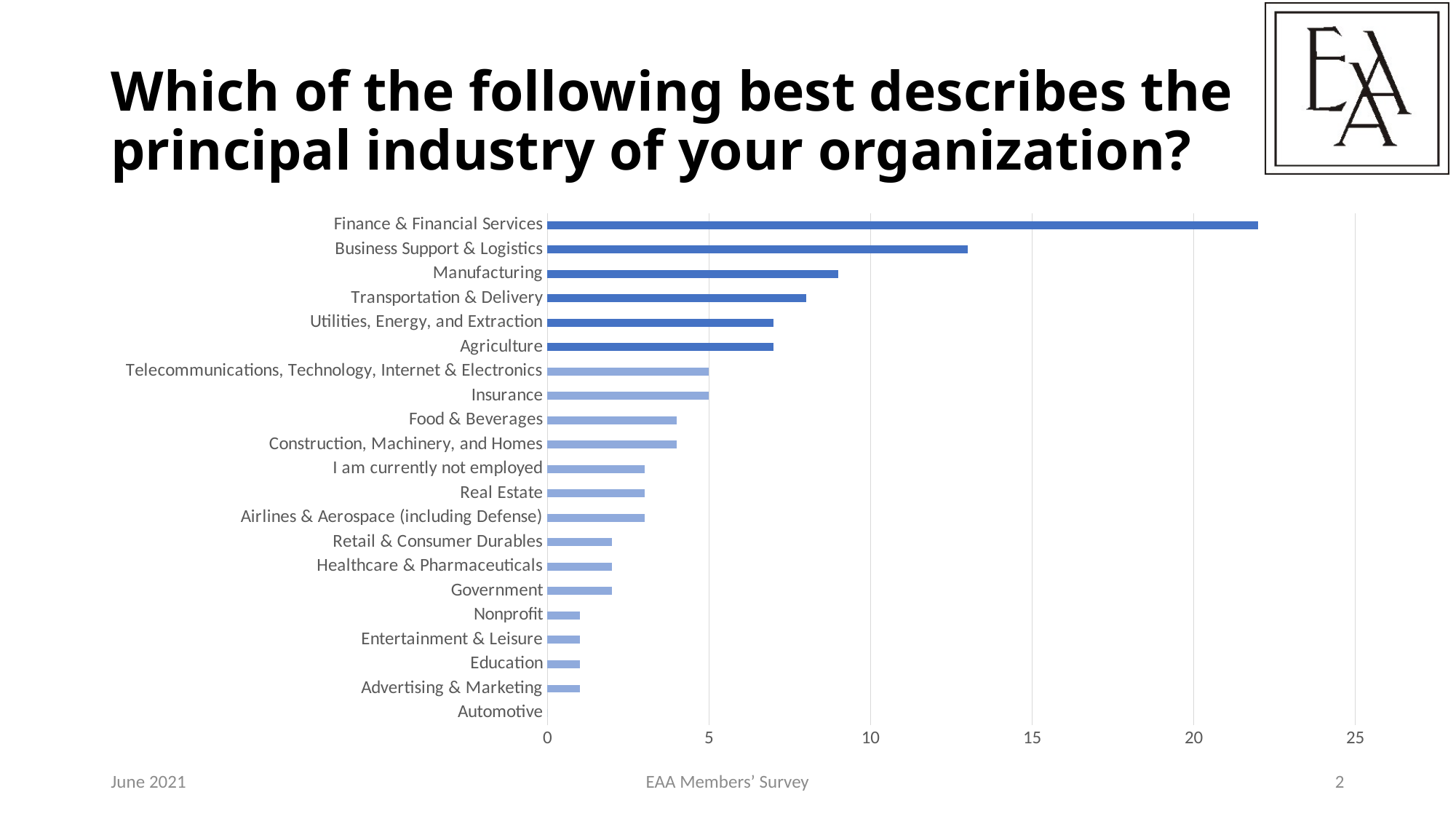
How many industry categories are listed on the chart? 21 Which has a larger value, Manufacturing or Education? Manufacturing Which industry category has the highest value? Finance & Financial Services What kind of chart is shown on the slide? bar chart Is the value for Nonprofit greater or less than 5? less Is the value for Agriculture greater or less than 5? greater What is the highest value shown on the horizontal axis of the chart? 25 Is the value for Manufacturing greater or less than 10? less Which industry category has the lowest value? Automotive Which has a larger value, Finance & Financial Services or Business Support & Logistics? Finance & Financial Services